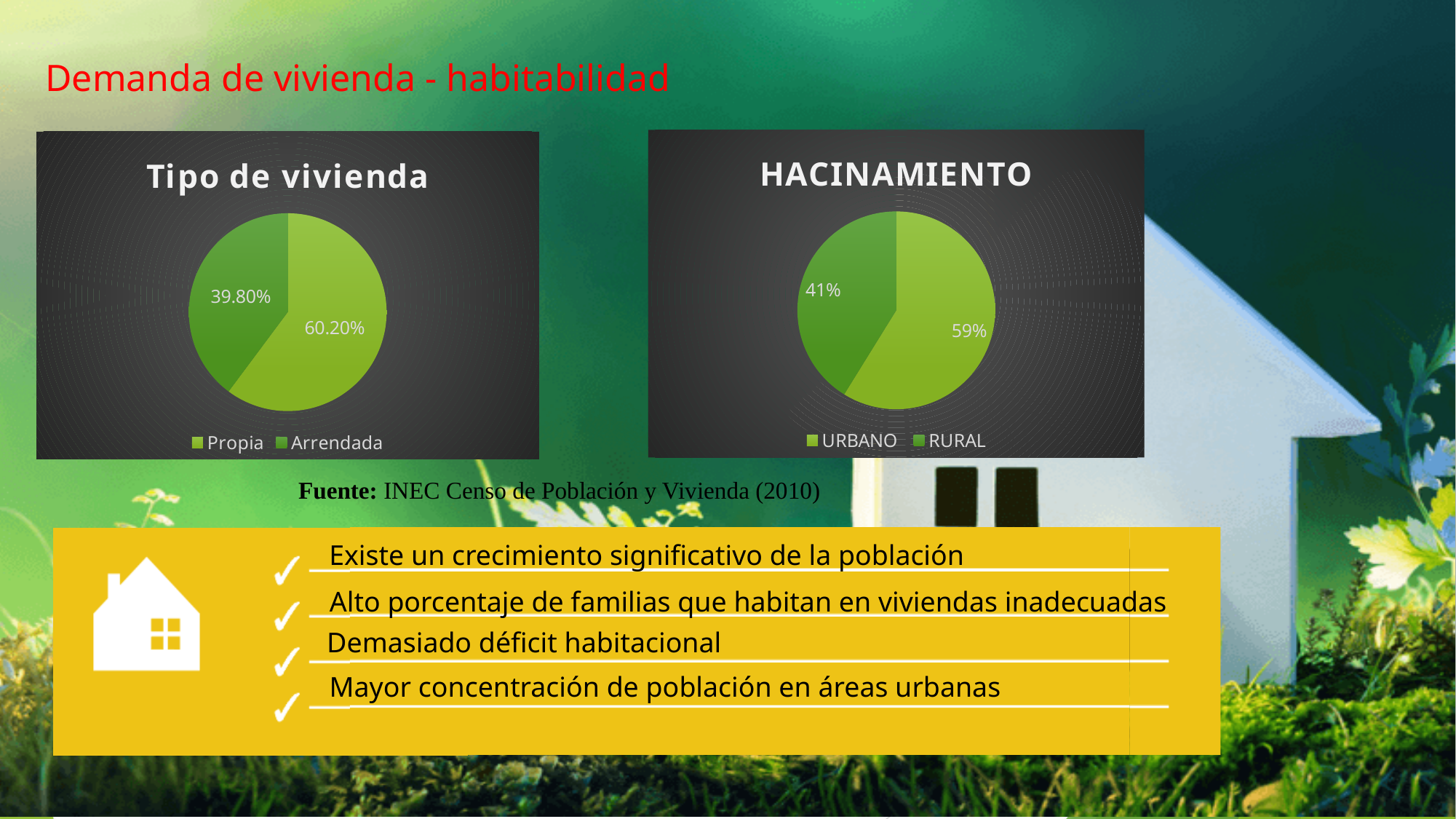
In the 'Tipo de vivienda' chart, what share is Propia? 60.20% In the 'HACINAMIENTO' chart, what share is RURAL? 41% What are the legend entries of the 'Tipo de vivienda' chart? Propia, Arrendada What kind of chart is the 'Tipo de vivienda' chart? Pie chart In the 'HACINAMIENTO' chart, which category has the smallest slice? RURAL How many slices does the 'HACINAMIENTO' pie chart have? 2 In the 'HACINAMIENTO' chart, which is larger, URBANO or RURAL? URBANO In the 'HACINAMIENTO' chart, what is the difference between the URBANO and RURAL shares? 18% In the 'Tipo de vivienda' chart, which category has the largest slice? Propia In the 'Tipo de vivienda' chart, what share is Arrendada? 39.80% In the 'HACINAMIENTO' chart, what share is URBANO? 59% In the 'Tipo de vivienda' chart, what is the difference between the Propia and Arrendada shares? 20.40%